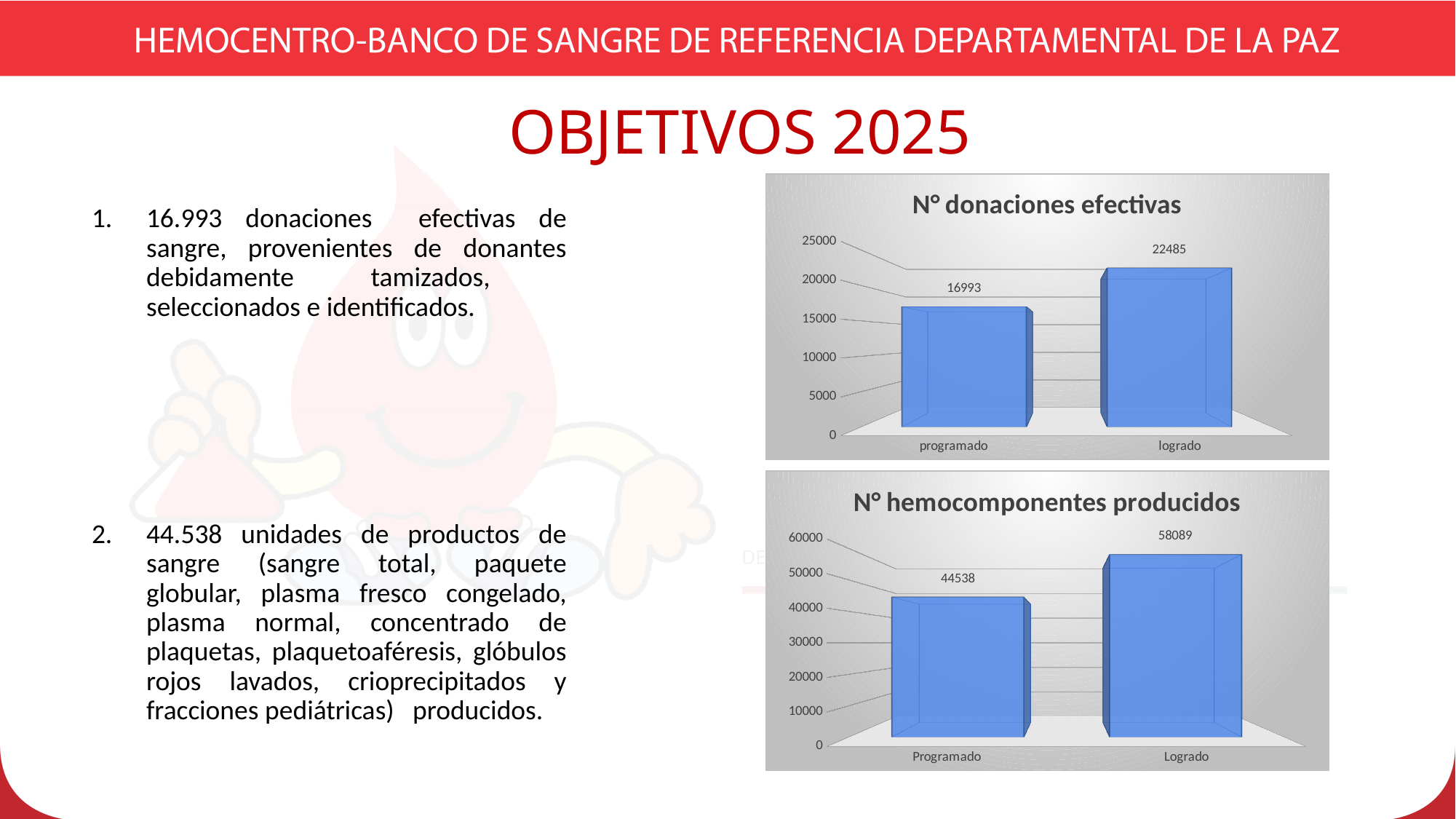
How many categories are shown in the 'N° hemocomponentes producidos' chart? 2 In the 'N° hemocomponentes producidos' chart, which category has the lower value? Programado In the 'N° donaciones efectivas' chart, what is the difference between 'logrado' and 'programado'? 5492 In the 'N° donaciones efectivas' chart, which category has the higher value? logrado In the 'N° hemocomponentes producidos' chart, is the value for 'Logrado' greater or less than 50000? greater What kind of chart is the 'N° donaciones efectivas' chart? bar chart In the 'N° donaciones efectivas' chart, what is the value for 'logrado'? 22485 In the 'N° hemocomponentes producidos' chart, what is the value for 'Programado'? 44538 In the 'N° donaciones efectivas' chart, is the value for 'programado' greater or less than 20000? less In the 'N° hemocomponentes producidos' chart, what is the difference between 'Logrado' and 'Programado'? 13551 In the 'N° hemocomponentes producidos' chart, what is the value for 'Logrado'? 58089 In the 'N° donaciones efectivas' chart, what is the value for 'programado'? 16993